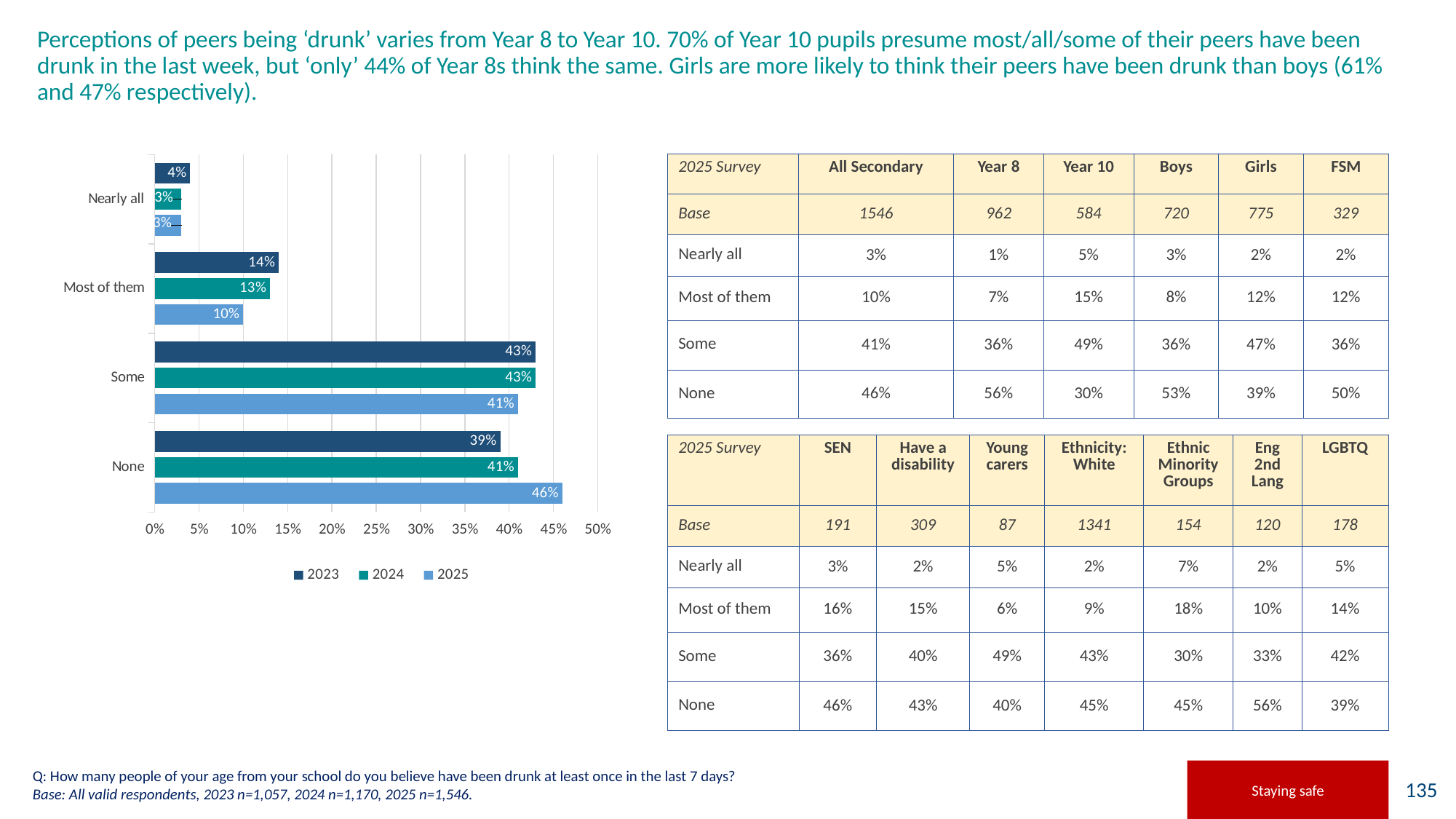
How many categories are shown on the chart? 4 What is the value for 'None' in the 2025 series? 46% How many series does the legend list? 3 What are the series names listed in the chart legend? 2023, 2024, 2025 What is the value for 'Most of them' in the 2023 series? 14% What is the difference between the 2025 and 2023 values for 'None'? 7% What kind of chart is shown on the slide? Bar chart What is the value for 'Some' in the 2025 series? 41% Which category has the lowest value in the 2023 series? Nearly all What is the value for 'Nearly all' in the 2024 series? 3% Which category has the highest value in the 2025 series? None Which is larger for 'Most of them': the 2023 value or the 2025 value? 2023